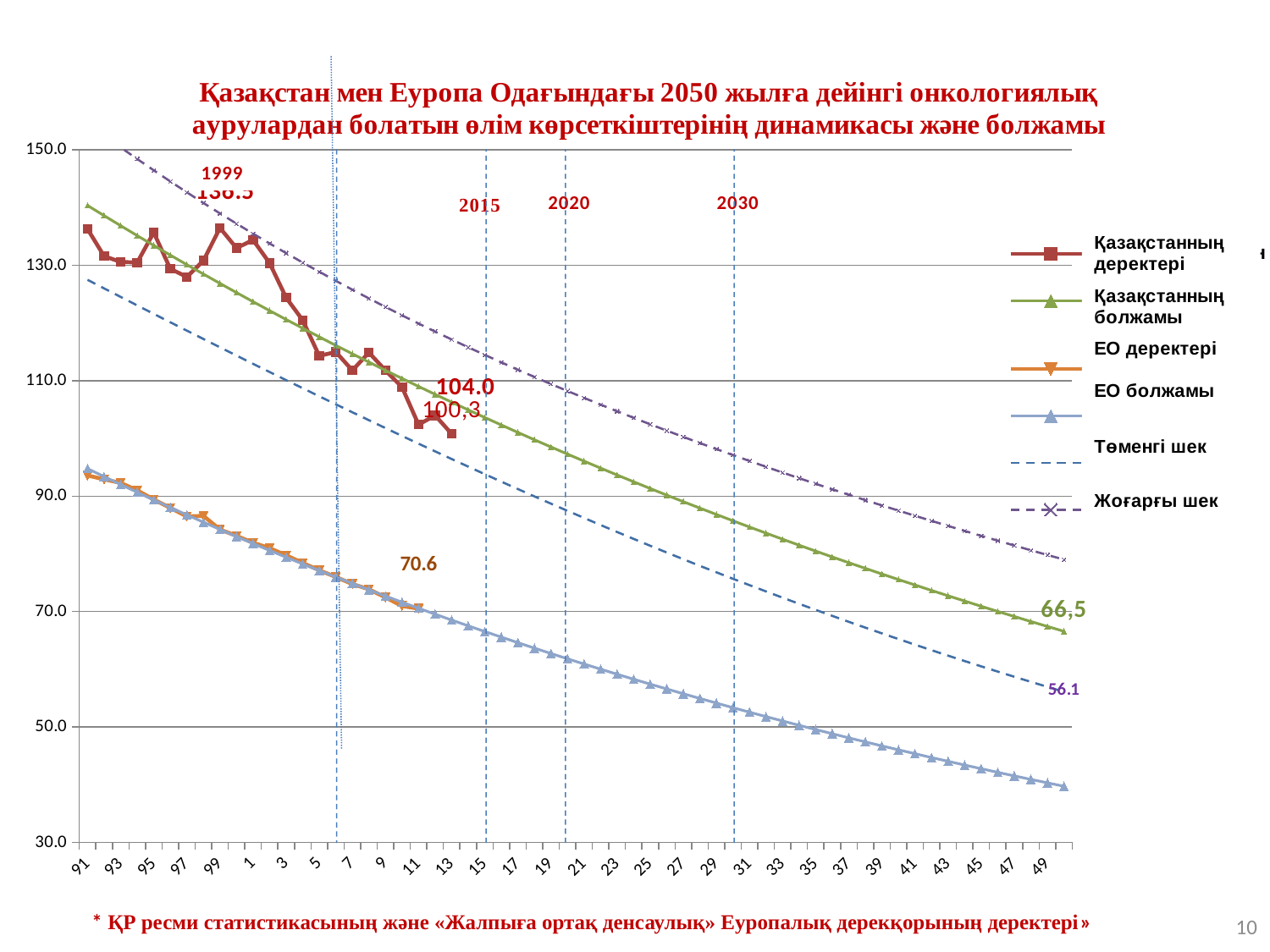
Is the value of the ЕО болжамы line at 49 greater or less than 50? less Which series is the highest at the right end of the chart? Жоғарғы шек What value is labelled at the right end of the Төменгі шек line? 56.1 What kind of chart is shown on the slide? line chart How many series does the legend list? 6 What value is labelled at the right end of the Қазақстанның болжамы line? 66,5 Which series is the lowest at the right end of the chart? ЕО болжамы At the start of the chart (91), which is higher: Қазақстанның деректері or ЕО деректері? Қазақстанның деректері What value is labelled at the end of the ЕО деректері line? 70.6 Is the value of the Жоғарғы шек line at 49 greater or less than 70? greater Does the Қазақстанның болжамы line rise or fall along the x axis? fall Which three years are marked by vertical dashed lines with labels on the chart? 2015, 2020, 2030